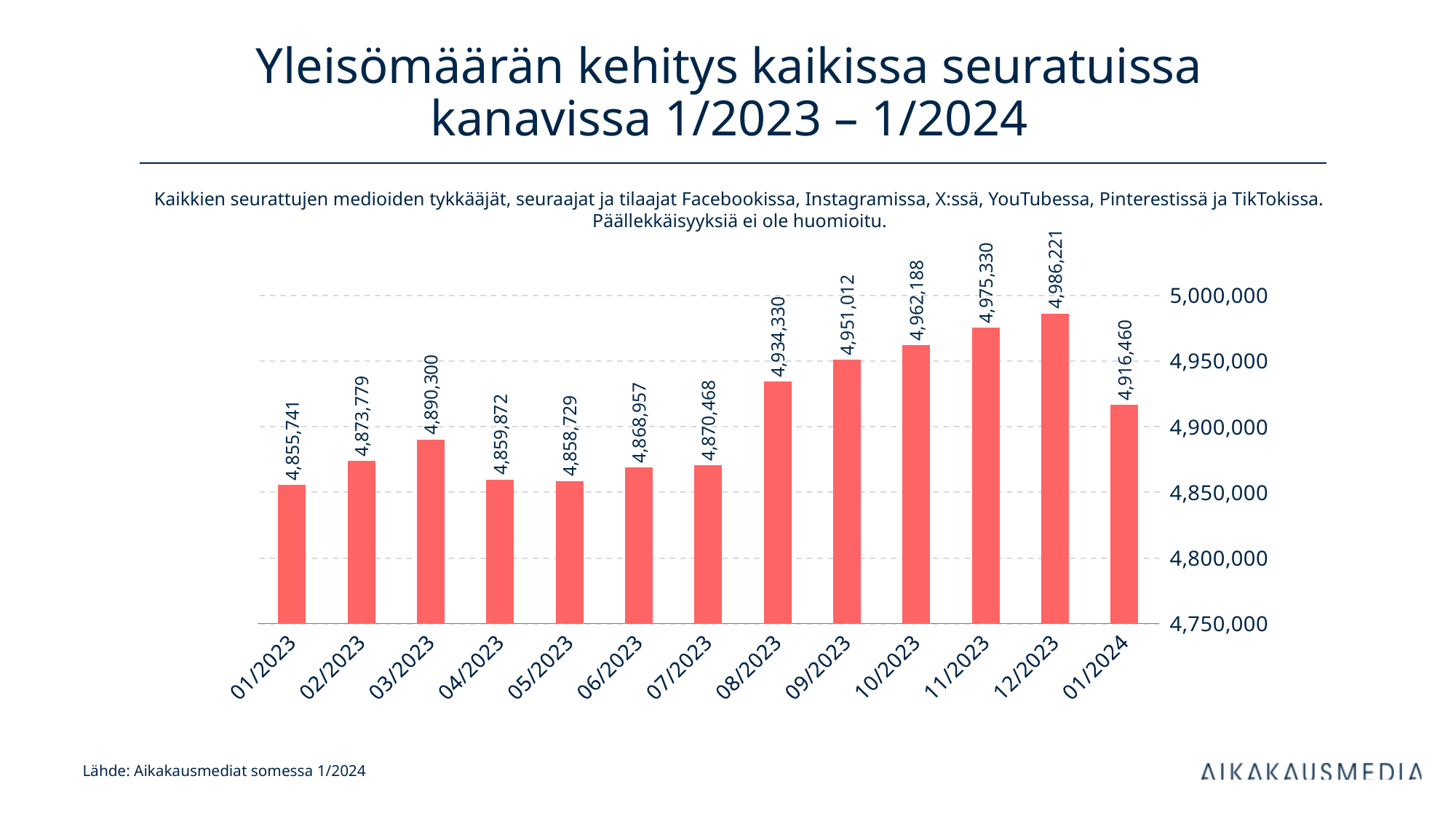
What is the difference between the values for 12/2023 and 01/2023? 130,480 What is the value for 01/2024? 4,916,460 How many months are shown on the x axis? 13 What is the value for 12/2023? 4,986,221 What is the difference between the values for 12/2023 and 01/2024? 69,761 Do the values rise or fall from 07/2023 to 12/2023? rise Is the value for 05/2023 greater or less than 4,900,000? less Which is larger, the value for 03/2023 or the value for 06/2023? 03/2023 Which month has the lowest value? 01/2023 What kind of chart is shown on the slide? bar chart Which month has the highest value? 12/2023 What is the value for 08/2023? 4,934,330